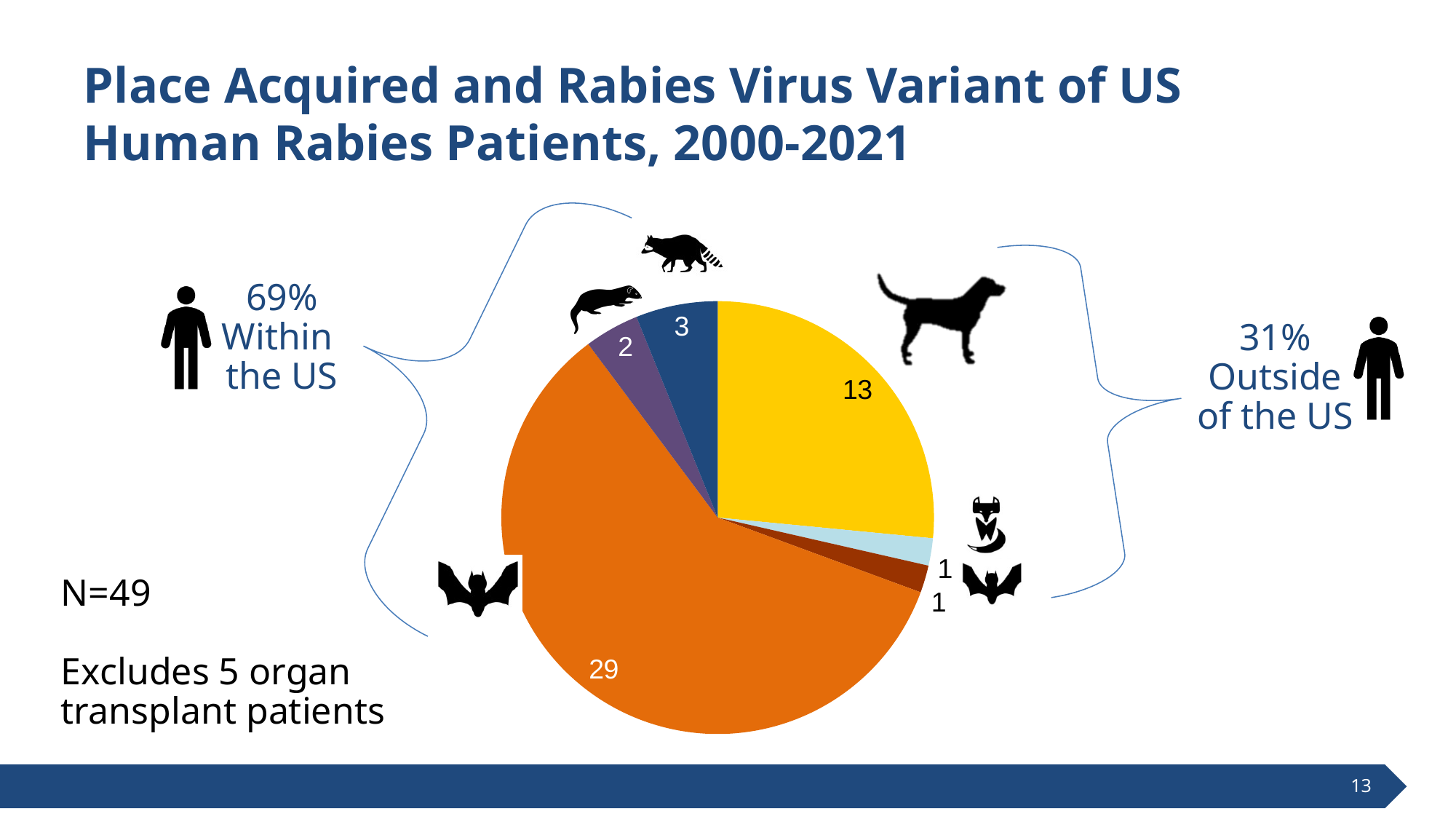
What is the smallest value shown on any slice of the pie chart? 1 What kind of chart is shown on the slide? pie chart How many slices does the pie chart have? 6 Which slice is larger, the yellow slice or the dark blue slice? the yellow slice What is the value of the largest slice of the pie chart? 29 What is the total number of patients (N) shown on the slide? 49 What is the value of the dark blue slice of the pie chart? 3 What percentage of patients acquired rabies outside of the US? 31% What is the value of the yellow slice of the pie chart? 13 What is the difference between the orange slice (29) and the yellow slice (13)? 16 What is the value of the purple slice of the pie chart? 2 What percentage of patients acquired rabies within the US? 69%